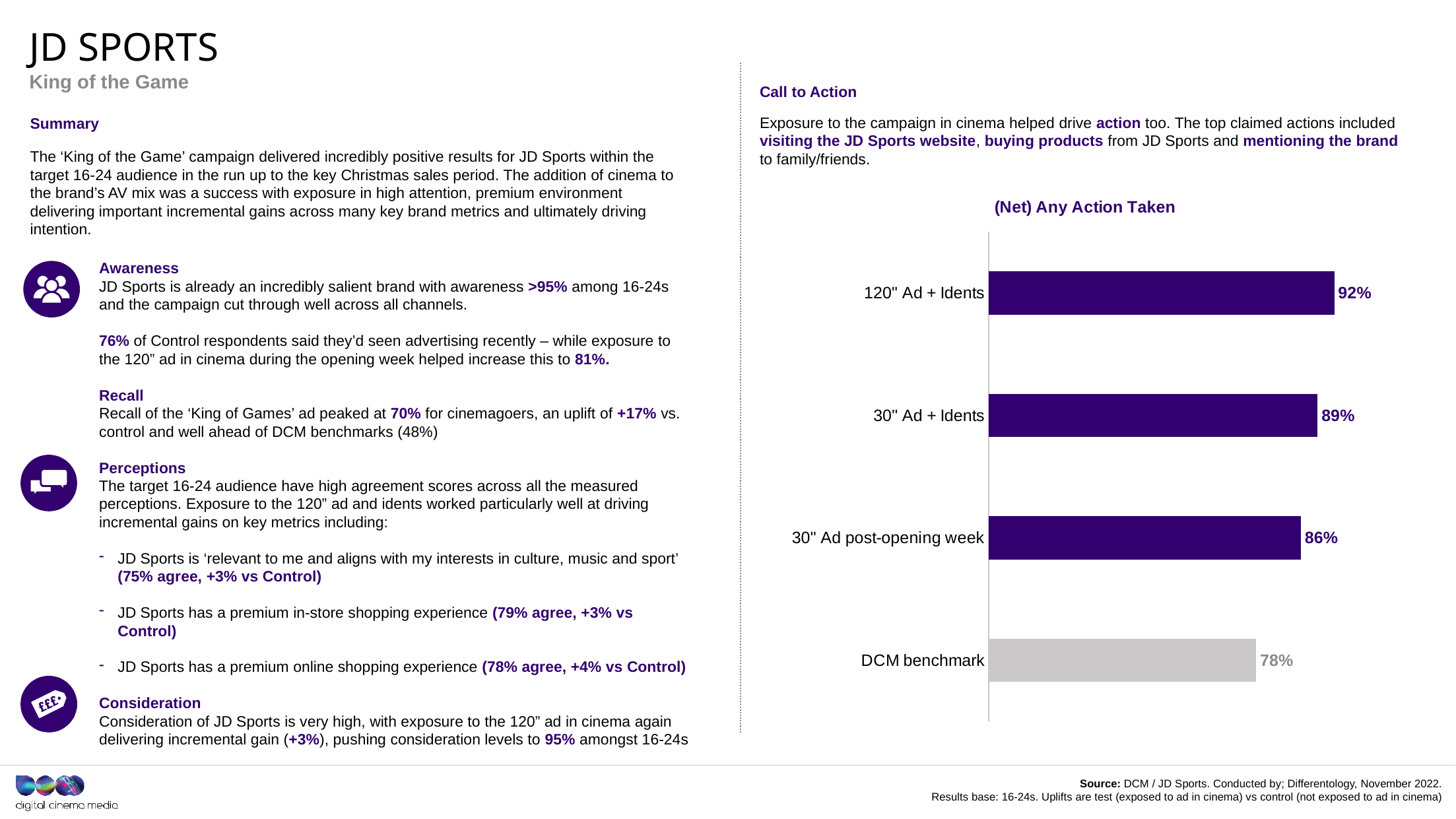
What is the difference between the 30" Ad + Idents value and the 30" Ad post-opening week value in the (Net) Any Action Taken chart? 3% What is the title of the chart on the slide? (Net) Any Action Taken What kind of chart is the (Net) Any Action Taken chart? Bar chart Which category has the lowest value in the (Net) Any Action Taken chart? DCM benchmark What is the value for DCM benchmark in the (Net) Any Action Taken chart? 78% Which category has the highest value in the (Net) Any Action Taken chart? 120" Ad + Idents What is the value for 120" Ad + Idents in the (Net) Any Action Taken chart? 92% What is the value for 30" Ad + Idents in the (Net) Any Action Taken chart? 89% How many categories are shown in the (Net) Any Action Taken chart? 4 What is the value for 30" Ad post-opening week in the (Net) Any Action Taken chart? 86% In the (Net) Any Action Taken chart, which is larger: 30" Ad post-opening week or DCM benchmark? 30" Ad post-opening week What is the difference between the 120" Ad + Idents value and the DCM benchmark value in the (Net) Any Action Taken chart? 14%